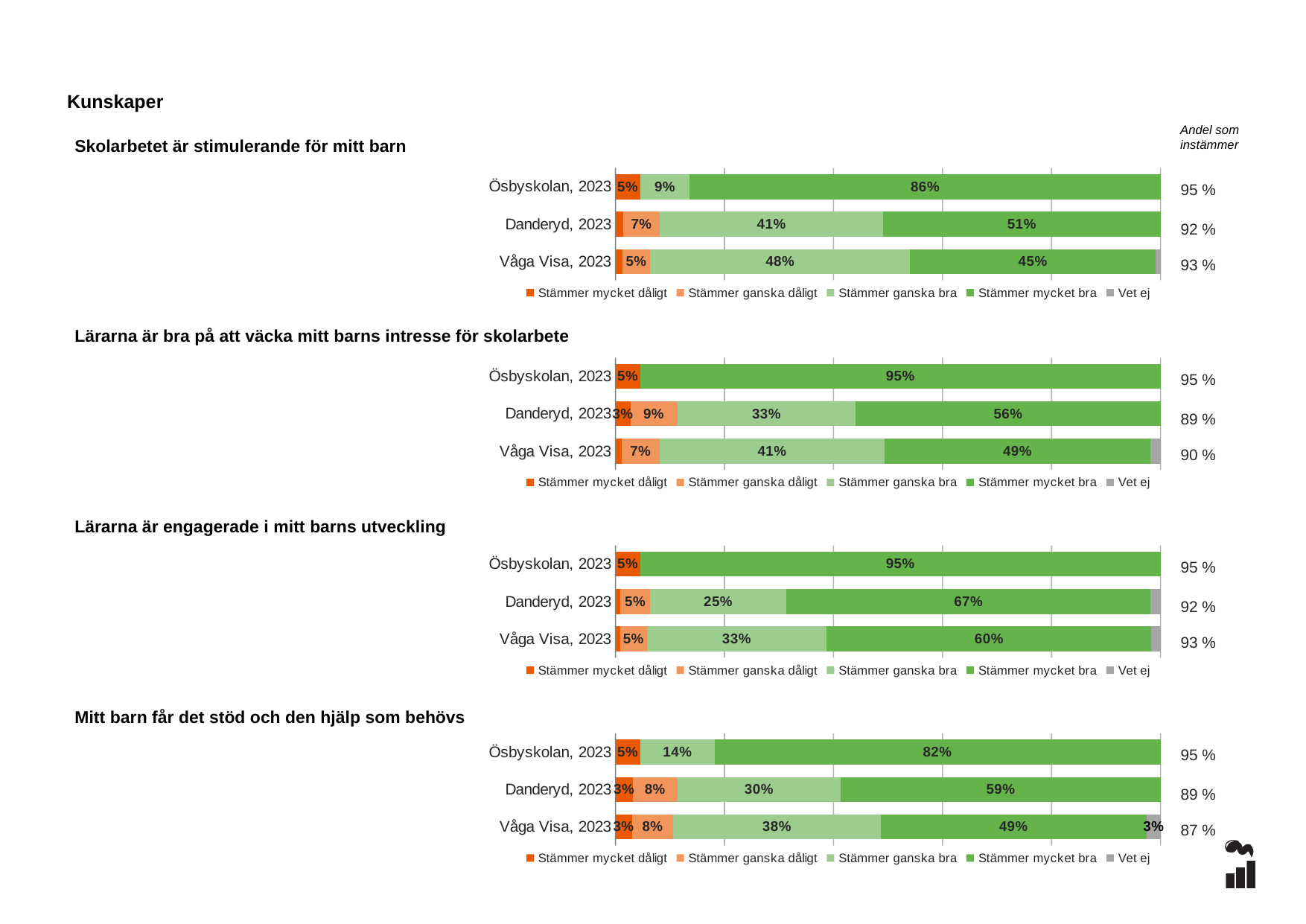
In the chart 'Lärarna är engagerade i mitt barns utveckling', which is larger: the 'Stämmer mycket bra' value for Danderyd, 2023 or for Våga Visa, 2023? Danderyd, 2023 In the chart 'Lärarna är bra på att väcka mitt barns intresse för skolarbete', what is the 'Stämmer mycket bra' value for Danderyd, 2023? 56% In the chart 'Lärarna är bra på att väcka mitt barns intresse för skolarbete', what is the difference between the 'Stämmer mycket bra' values for Ösbyskolan, 2023 and Våga Visa, 2023? 46% In the chart 'Skolarbetet är stimulerande för mitt barn', what is the 'Stämmer ganska bra' value for Våga Visa, 2023? 48% In the chart 'Mitt barn får det stöd och den hjälp som behövs', what is the 'Andel som instämmer' for Våga Visa, 2023? 87 % In the chart 'Skolarbetet är stimulerande för mitt barn', which row has the highest 'Stämmer mycket bra' value? Ösbyskolan, 2023 How many series does the legend list in the chart 'Skolarbetet är stimulerande för mitt barn'? 5 In the chart 'Lärarna är engagerade i mitt barns utveckling', what is the 'Stämmer ganska bra' value for Danderyd, 2023? 25% In the chart 'Skolarbetet är stimulerande för mitt barn', what is the 'Stämmer mycket bra' value for Ösbyskolan, 2023? 86% What kind of chart is 'Lärarna är engagerade i mitt barns utveckling'? Stacked bar chart In the chart 'Mitt barn får det stöd och den hjälp som behövs', what is the 'Vet ej' value for Våga Visa, 2023? 3%